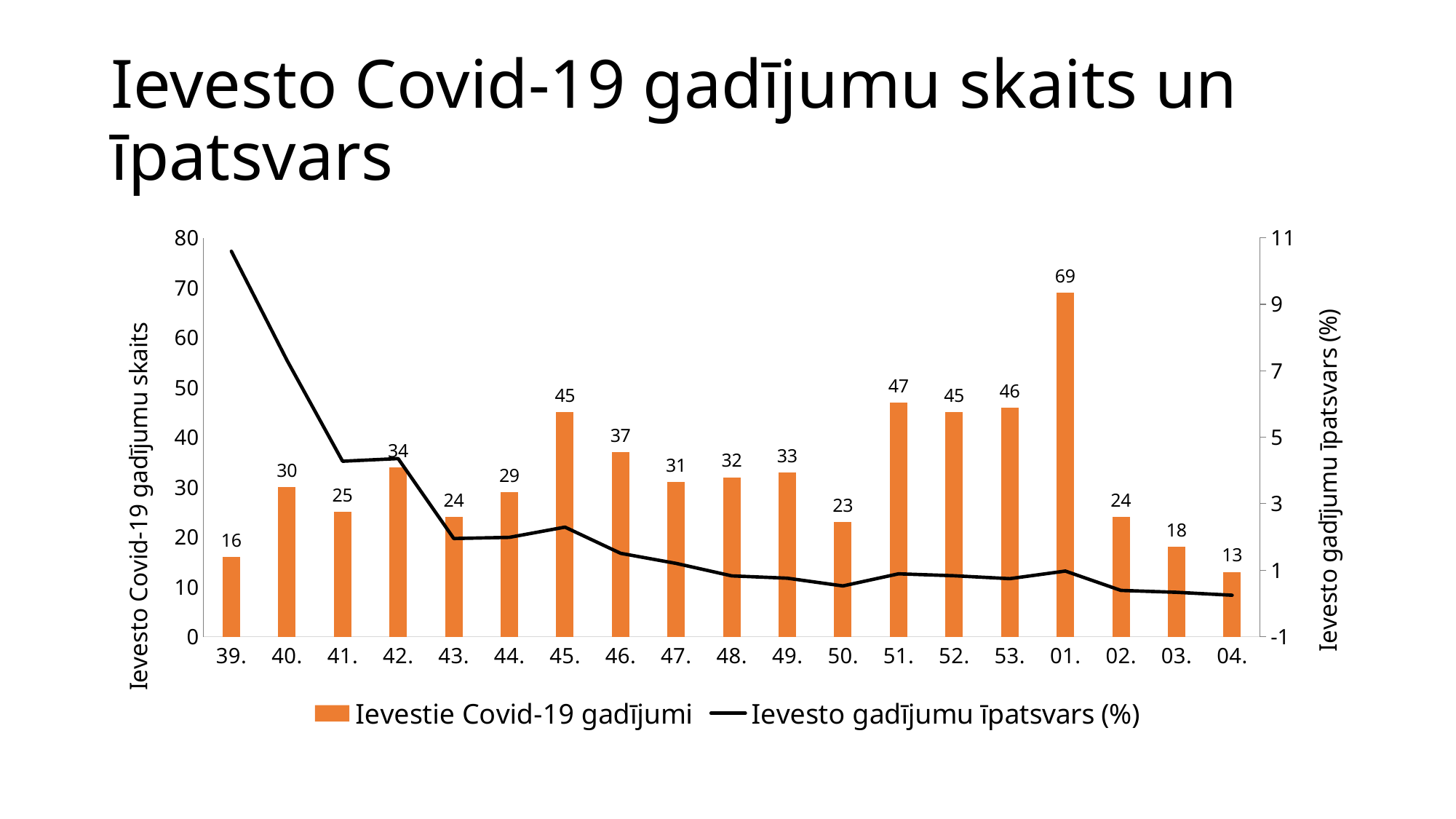
Is the value of Ievesto gadījumu īpatsvars (%) for week 04. greater or less than 1? less Is the value of Ievesto gadījumu īpatsvars (%) for week 39. greater or less than 9? greater What is the value of Ievestie Covid-19 gadījumi for week 01.? 69 Which week has the lowest number of Ievestie Covid-19 gadījumi? 04. How many series does the legend list? 2 What is the value of Ievestie Covid-19 gadījumi for week 45.? 45 Which week has the highest number of Ievestie Covid-19 gadījumi? 01. Does the Ievesto gadījumu īpatsvars (%) line generally rise or fall from week 39. to week 04.? fall How many weeks are shown on the x axis? 19 What is the difference between the Ievestie Covid-19 gadījumi values for week 01. and week 02.? 45 Which has more Ievestie Covid-19 gadījumi, week 46. or week 50.? 46. What is the value of Ievestie Covid-19 gadījumi for week 39.? 16